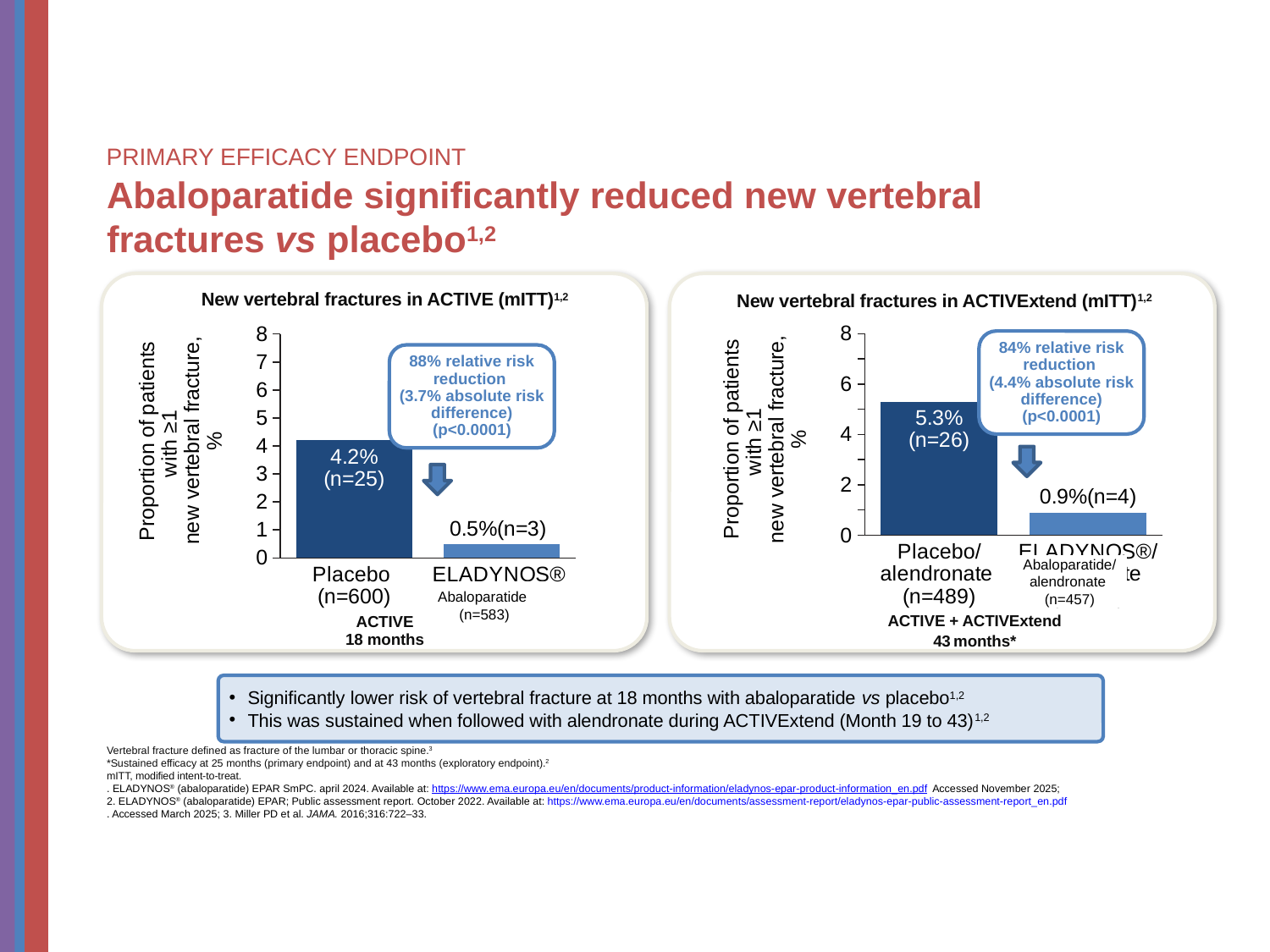
In the 'New vertebral fractures in ACTIVEExtend (mITT)' chart, which category has the lowest value? ELADYNOS/alendronate In the 'New vertebral fractures in ACTIVEExtend (mITT)' chart, what is the value for Placebo/alendronate? 5.3% In the 'New vertebral fractures in ACTIVE (mITT)' chart, what relative risk reduction is stated in the callout? 88% relative risk reduction In the 'New vertebral fractures in ACTIVE (mITT)' chart, what is the value for Placebo? 4.2% In the 'New vertebral fractures in ACTIVE (mITT)' chart, which category has the highest value? Placebo In the 'New vertebral fractures in ACTIVE (mITT)' chart, what is the difference between the Placebo and ELADYNOS values? 3.7% In the 'New vertebral fractures in ACTIVEExtend (mITT)' chart, what is the value for ELADYNOS/alendronate? 0.9% What kind of chart is the 'New vertebral fractures in ACTIVEExtend (mITT)' chart? Bar chart In the 'New vertebral fractures in ACTIVEExtend (mITT)' chart, is the value for Placebo/alendronate greater or less than 4? greater How many categories are shown in the 'New vertebral fractures in ACTIVE (mITT)' chart? 2 In the 'New vertebral fractures in ACTIVE (mITT)' chart, what is the value for ELADYNOS (abaloparatide)? 0.5% In the 'New vertebral fractures in ACTIVEExtend (mITT)' chart, what is the difference between the Placebo/alendronate and ELADYNOS/alendronate values? 4.4%